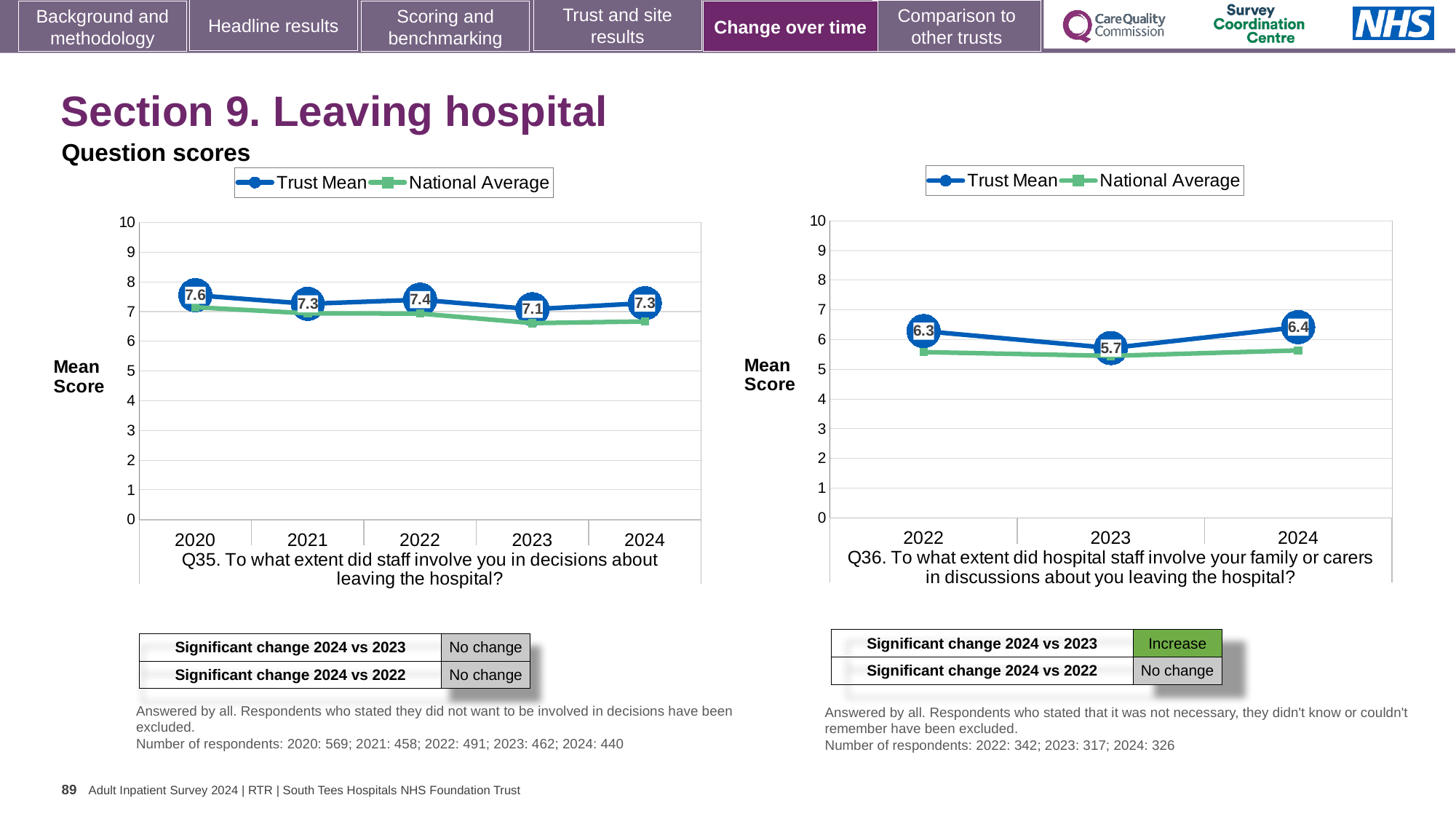
In the Q35 chart (left), what is the Trust Mean score for 2020? 7.6 In the Q35 chart (left), what is the difference between the Trust Mean scores for 2020 and 2023? 0.5 In the Q35 chart (left), what is the Trust Mean score for 2023? 7.1 In the Q36 chart (right), what is the difference between the Trust Mean scores for 2024 and 2023? 0.7 How many series does the legend of the Q36 chart (right) list? 2 In the Q36 chart (right), what is the Trust Mean score for 2024? 6.4 In the Q35 chart (left), is the Trust Mean score higher in 2022 or in 2021? 2022 How many years are shown on the x axis of the Q35 chart (left)? 5 In the Q35 chart (left), which year has the highest Trust Mean score? 2020 In the Q36 chart (right), is the National Average value for 2023 greater or less than 6? less In the Q36 chart (right), which year has the lowest Trust Mean score? 2023 What type of chart is used for the Q35 chart (left)? Line chart